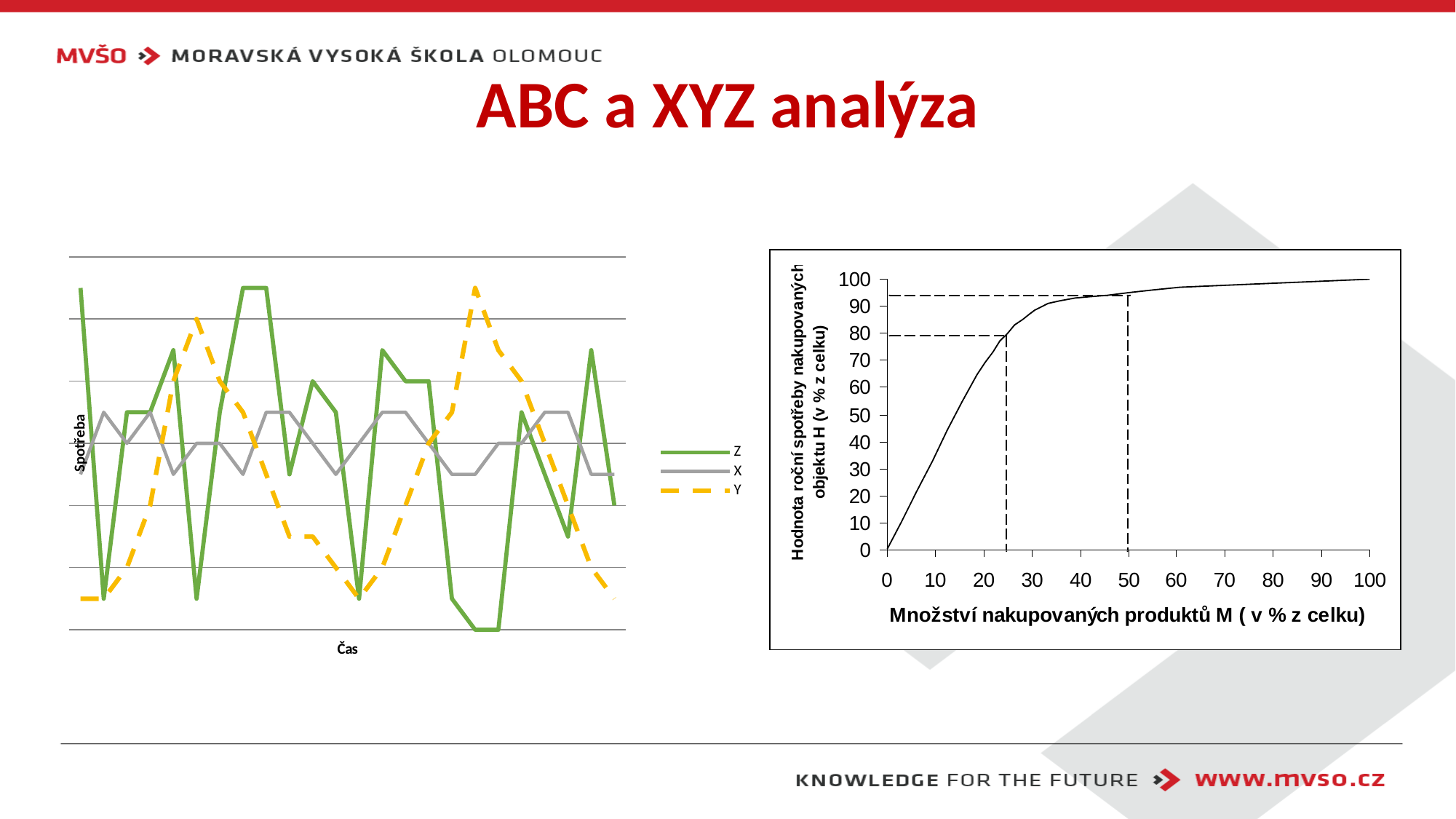
How many series does the legend of the left chart list? 3 What is the label of the horizontal axis of the left chart? Čas In the right chart, is the value of H at M = 25 greater or less than 90? less What kind of chart is the chart on the left of the slide? line chart In the right chart, does the curve rise or fall as the quantity M increases along the x axis? rises What kind of chart is the chart on the right of the slide? line chart In the left chart, which series is drawn with a dashed line? Y What are the series names in the legend of the left chart? Z, X, Y In the right chart, is the value of H at M = 10 greater or less than 20? greater In the right chart, is the value of H at M = 50 greater or less than 90? greater In the right chart, what is the value of H at M = 100? 100 How many tick labels are shown on the x axis of the right chart? 11